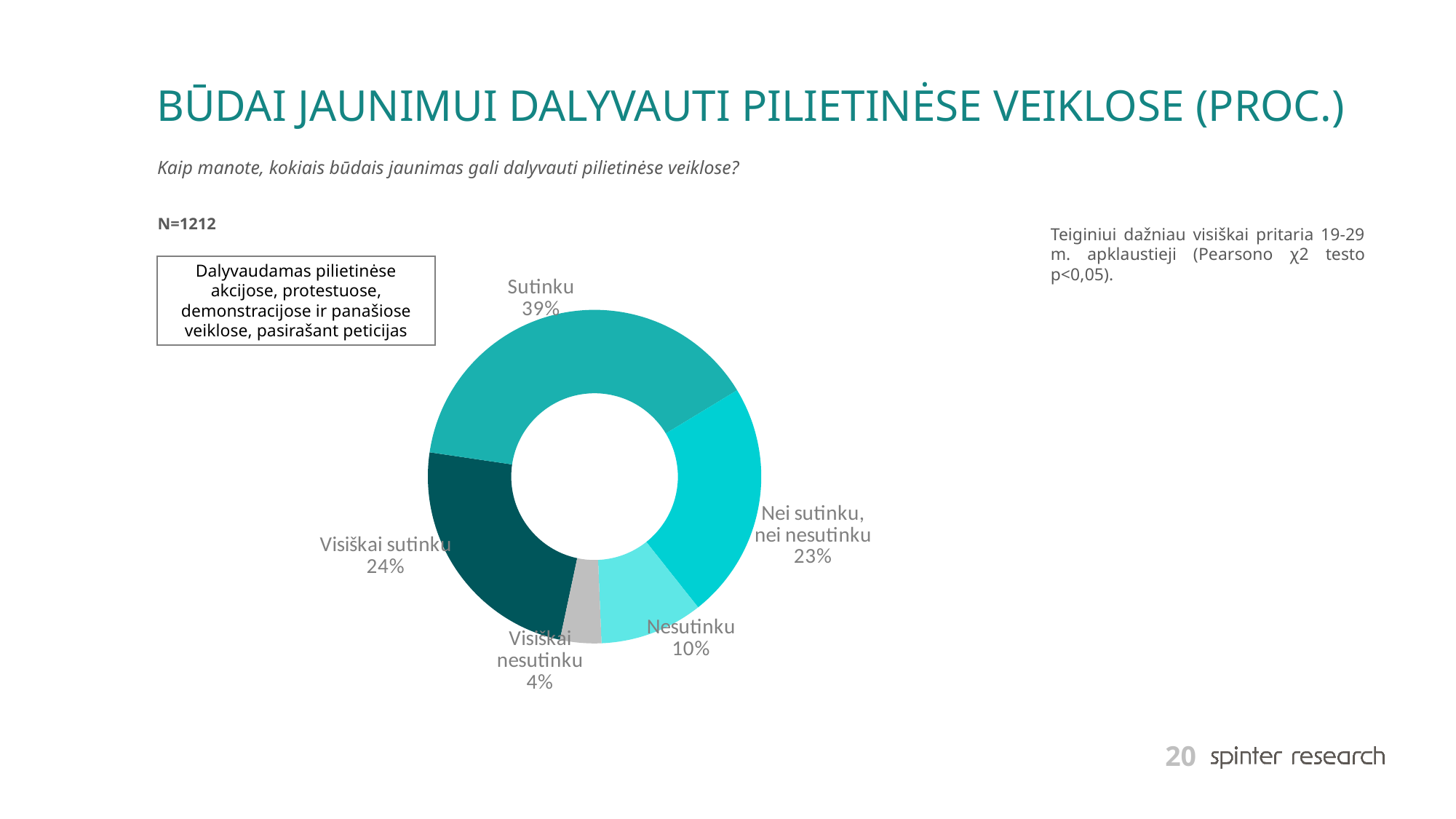
What type of chart is shown on the slide? Doughnut (pie) chart How many response categories are shown in the chart? 5 What is the sample size (N) stated on the slide? N=1212 Which is larger: the share for "Nesutinku" or the share for "Nei sutinku, nei nesutinku"? Nei sutinku, nei nesutinku Which response category has the smallest share of the chart? Visiškai nesutinku What is the difference in percentage points between "Sutinku" and "Visiškai sutinku"? 15 What percentage of respondents answered "Visiškai sutinku"? 24% What percentage of respondents answered "Nesutinku"? 10% What percentage of respondents answered "Visiškai nesutinku"? 4% What percentage of respondents answered "Sutinku"? 39% What percentage of respondents answered "Nei sutinku, nei nesutinku"? 23% Which response category has the largest share of the chart? Sutinku